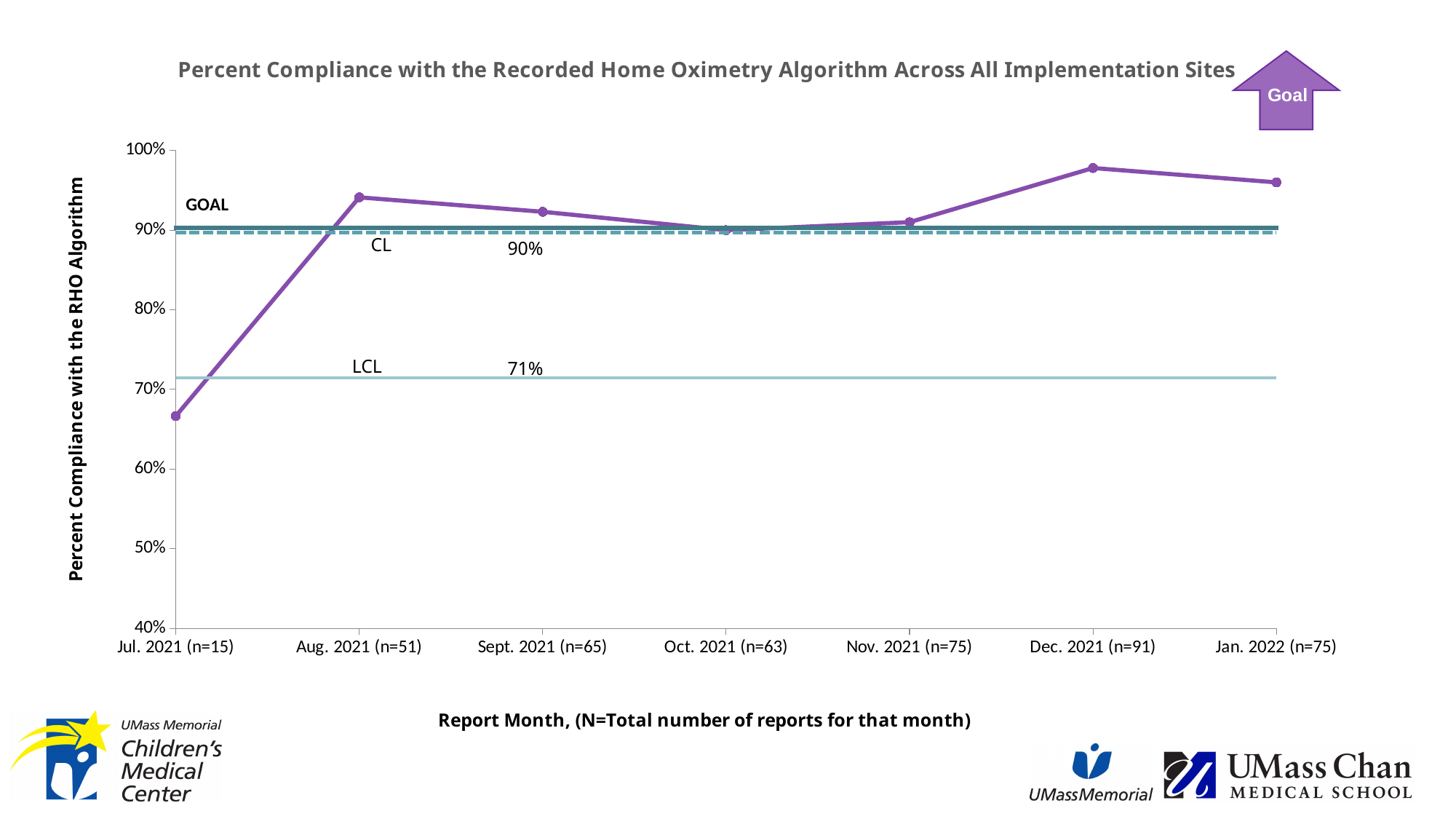
How many report months are plotted on the x axis? 7 What value is labelled for the LCL line on the chart? 71% Is the percent compliance for Jul. 2021 greater or less than 70%? less Which report month has the highest percent compliance with the RHO Algorithm? Dec. 2021 (n=91) What value is labelled for the CL line on the chart? 90% Which is larger, the percent compliance for Aug. 2021 or for Jul. 2021? Aug. 2021 Does the percent compliance rise or fall from Jul. 2021 to Aug. 2021? rise What is the total number of reports (n) for Dec. 2021 as shown on the x axis? 91 Which report month has the lowest percent compliance with the RHO Algorithm? Jul. 2021 (n=15) Is the percent compliance for Jan. 2022 greater or less than 90%? greater Is the percent compliance for Dec. 2021 greater or less than 90%? greater What kind of chart is shown on the slide? line chart